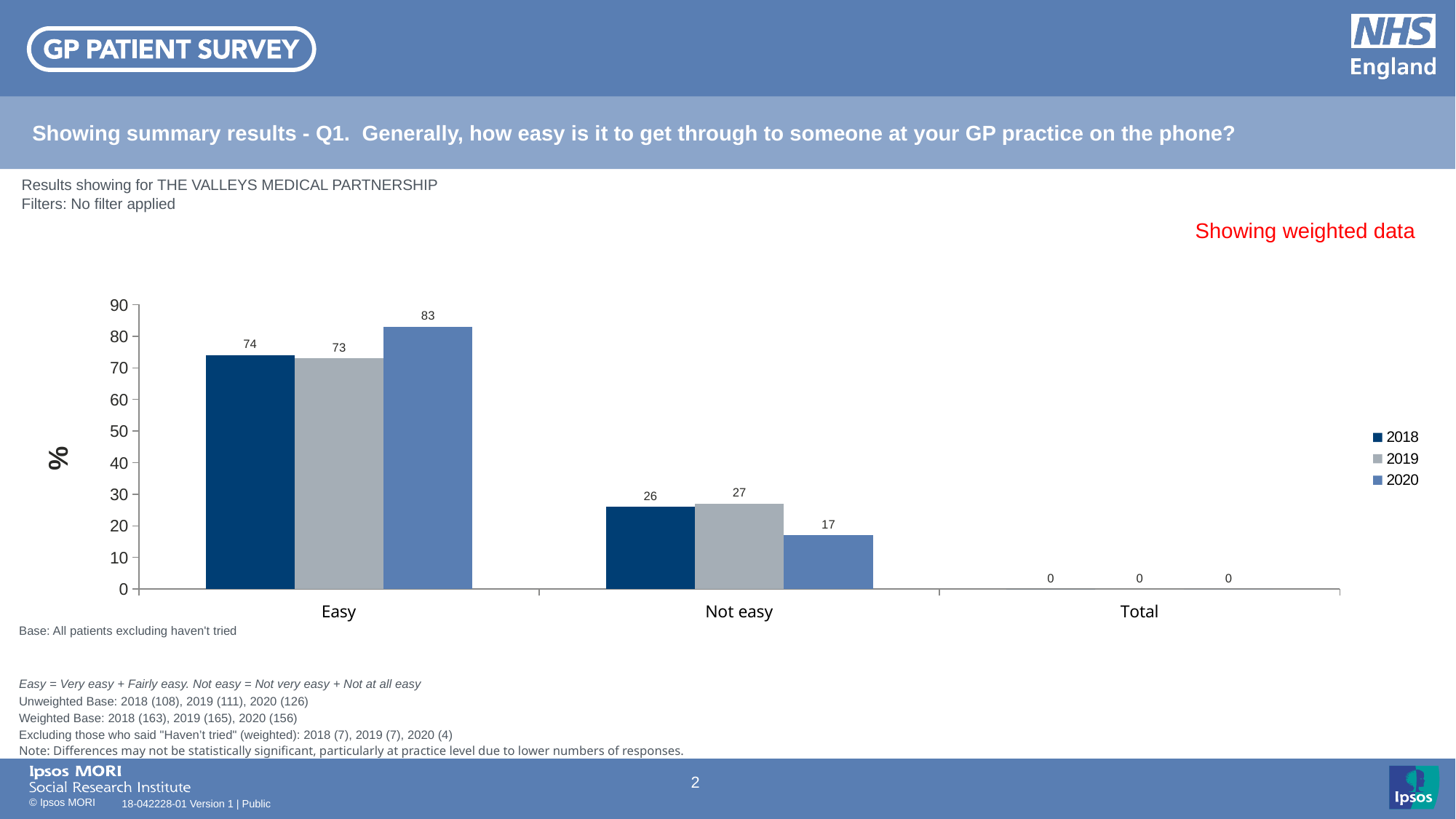
What is the difference between the Easy values for 2020 and 2018? 9 What kind of chart is shown on the slide? Bar chart What label is shown on the vertical axis? % What is the difference between the Not easy values for 2019 and 2020? 10 What is the value for Easy in 2019? 73 Which year has the highest value for Easy? 2020 What is the value for Not easy in 2020? 17 What is the value for Easy in 2020? 83 How many series does the legend list? 3 Which year has the lowest value for Not easy? 2020 Which is larger, the Easy value for 2018 or the Easy value for 2019? 2018 What is the value for Not easy in 2018? 26